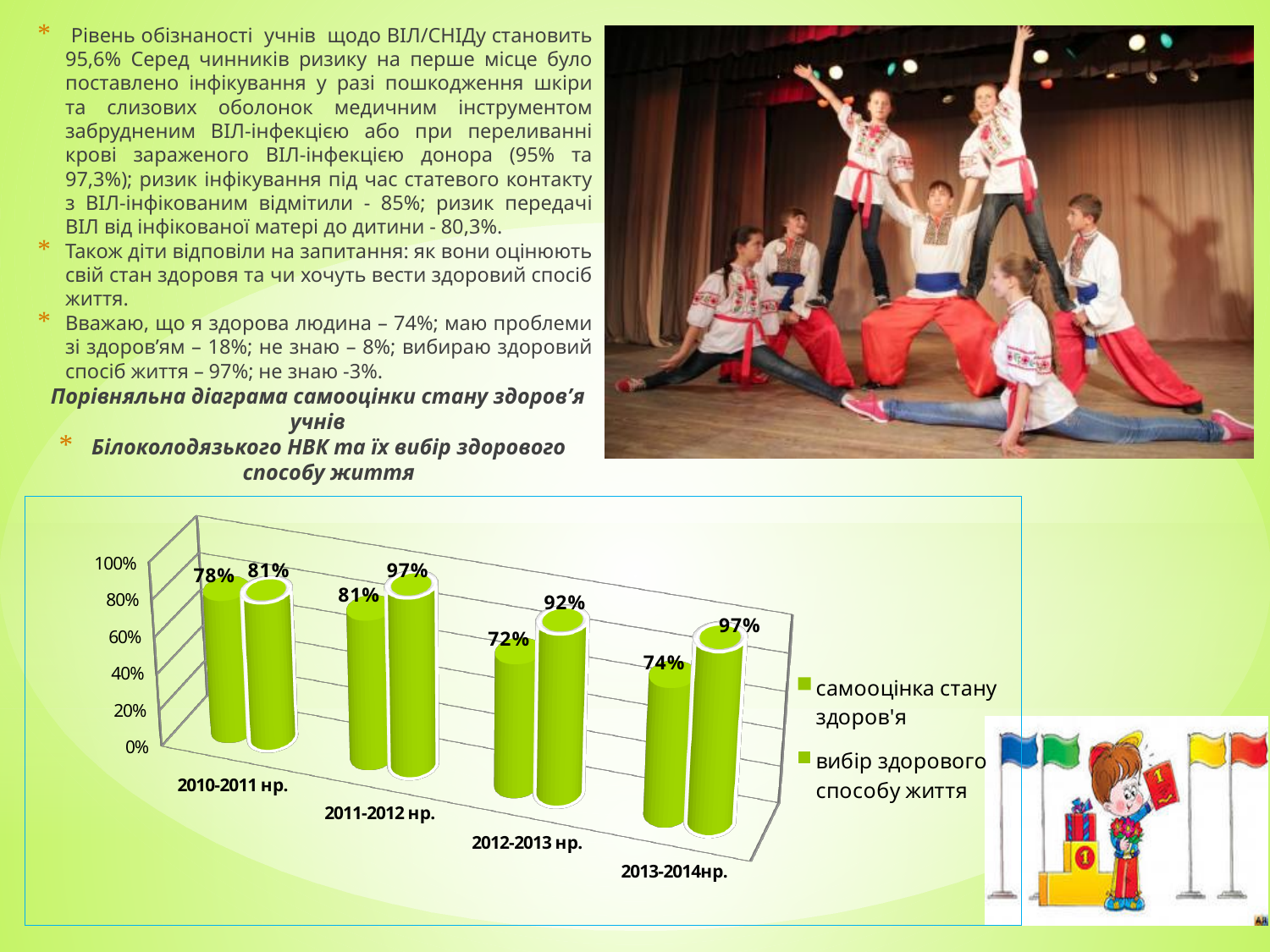
What is the value for вибір здорового способу життя in 2011-2012 нр.? 97% Does вибір здорового способу життя rise or fall from 2010-2011 нр. to 2011-2012 нр.? rise What is the difference between вибір здорового способу життя and самооцінка стану здоров'я in 2013-2014нр.? 23% Which is larger in 2012-2013 нр.: самооцінка стану здоров'я or вибір здорового способу життя? вибір здорового способу життя In which school year is самооцінка стану здоров'я the highest? 2011-2012 нр. How many series does the chart legend list? 2 What kind of chart is shown on the slide? bar chart How many school years are shown on the x axis of the chart? 4 What is the value for самооцінка стану здоров'я in 2010-2011 нр.? 78% In which school year is самооцінка стану здоров'я the lowest? 2012-2013 нр. What is the value for самооцінка стану здоров'я in 2012-2013 нр.? 72% What is the value for вибір здорового способу життя in 2013-2014нр.? 97%